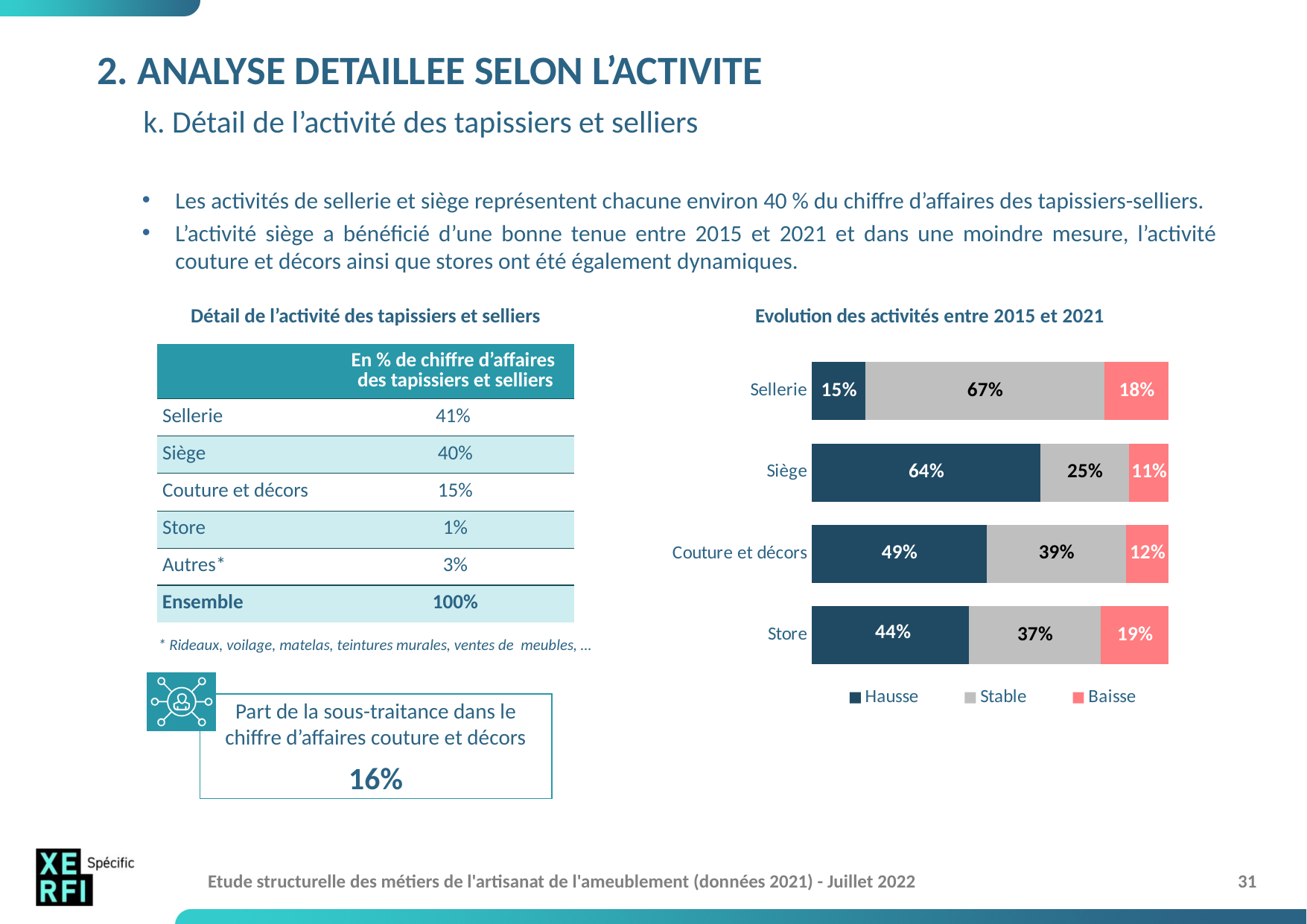
In the chart 'Evolution des activités entre 2015 et 2021', what is the Hausse value for Siège? 64% In the chart 'Evolution des activités entre 2015 et 2021', which activity has the lowest Baisse value? Siège In the chart 'Evolution des activités entre 2015 et 2021', which activity has the highest Hausse value? Siège In the chart 'Evolution des activités entre 2015 et 2021', is the Stable value larger for Sellerie or for Store? Sellerie In the chart 'Evolution des activités entre 2015 et 2021', which activity has the lowest Hausse value? Sellerie How many series does the legend of the chart 'Evolution des activités entre 2015 et 2021' list? 3 In the chart 'Evolution des activités entre 2015 et 2021', what is the Baisse value for Store? 19% In the chart 'Evolution des activités entre 2015 et 2021', what is the Stable value for Couture et décors? 39% In the chart 'Evolution des activités entre 2015 et 2021', what is the Stable value for Sellerie? 67% In the chart 'Evolution des activités entre 2015 et 2021', what is the difference between the Hausse values for Siège and Sellerie? 49 percentage points How many activities are shown in the chart 'Evolution des activités entre 2015 et 2021'? 4 What kind of chart is 'Evolution des activités entre 2015 et 2021'? Stacked bar chart